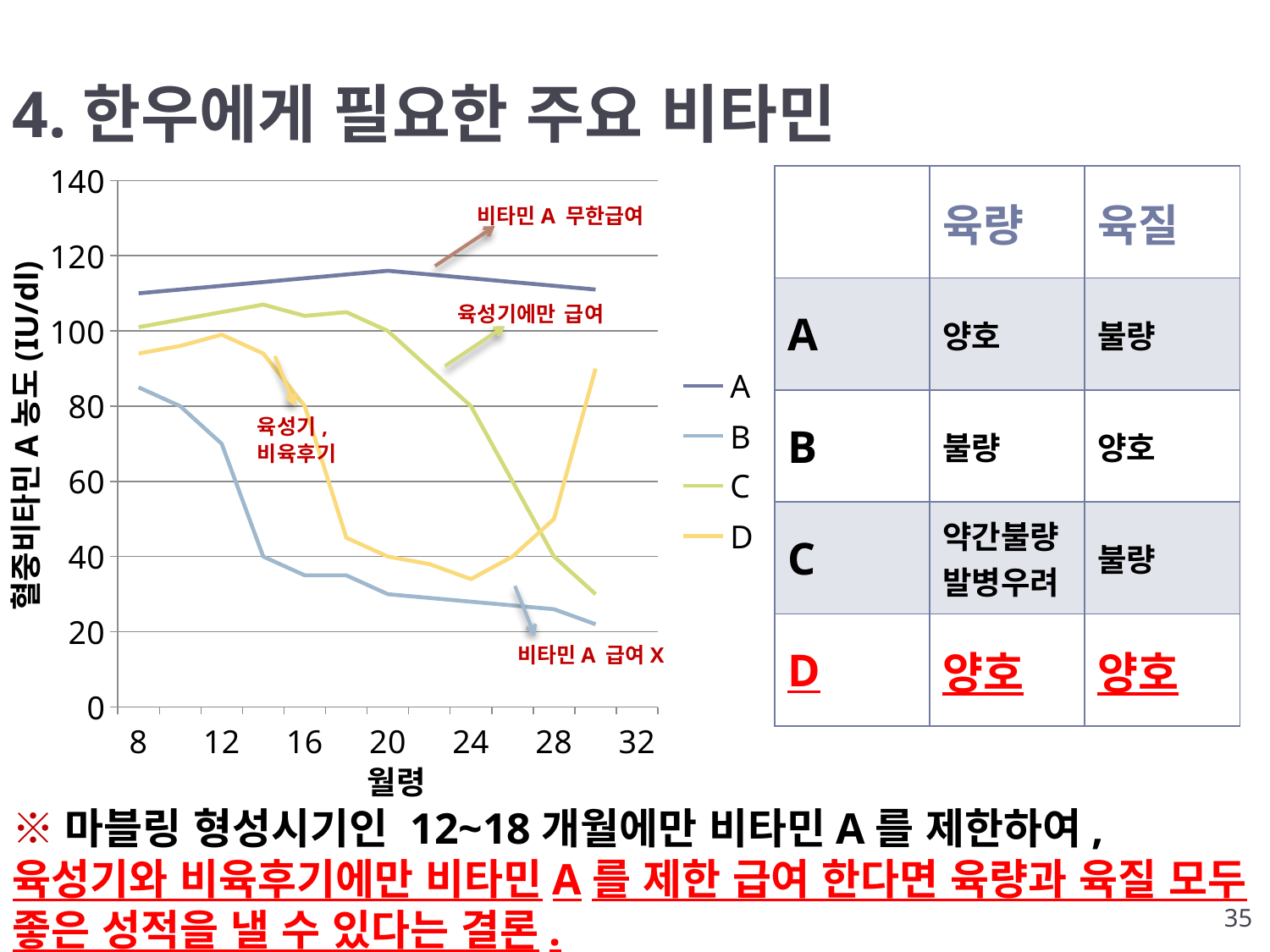
Do the values for series B rise or fall as the month increases from 8 to 30? fall What is the title of the chart's x axis? 월령 What kind of chart is shown on the slide? line chart Is the value for series C at month 30 greater or less than 40? less How many series does the chart legend list? 4 Is the value for series A at month 8 greater or less than 100? greater What are the series names listed in the chart legend? A, B, C, D Which series has the lowest value at month 30? B Which series has the highest value at month 20? A At month 8, which series has the larger value, A or B? A Is the value for series D at month 30 greater or less than 80? greater